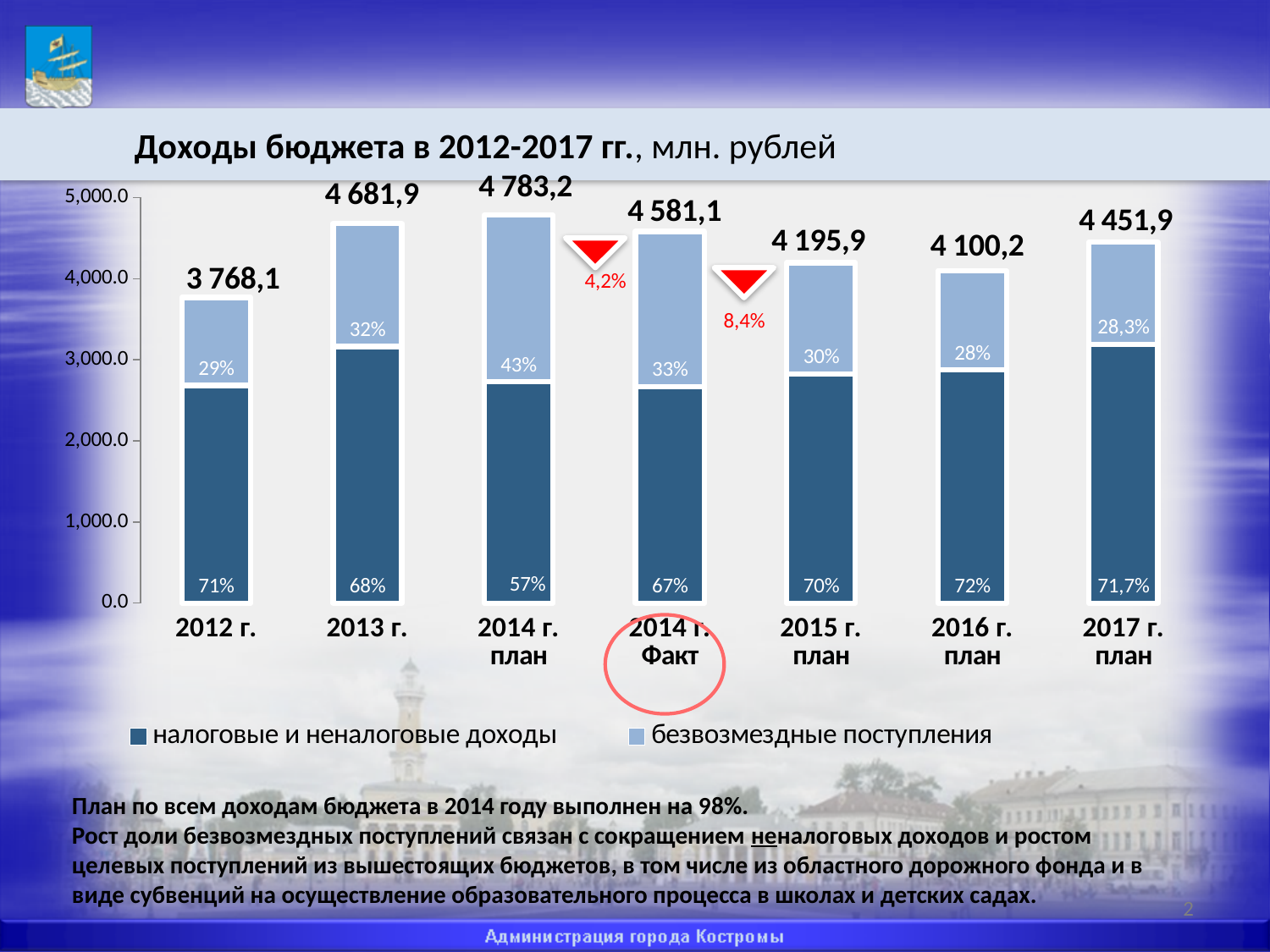
How many series does the legend list? 2 What is the total budget revenue shown for 2014 г. план? 4 783,2 Which is larger, the total for 2015 г. план or the total for 2016 г. план? 2015 г. план What percentage share do безвозмездные поступления make up in 2014 г. план? 43% What percentage share do налоговые и неналоговые доходы make up in 2017 г. план? 71,7% How many bars (categories) are shown on the chart? 7 Which year/category has the lowest total budget revenue? 2012 г. Which year/category has the highest total budget revenue? 2014 г. план Is the value of налоговые и неналоговые доходы for 2012 г. greater or less than 3,000.0? less What kind of chart is shown on the slide? Stacked bar chart What is the total budget revenue shown for 2017 г. план? 4 451,9 What is the difference between the total for 2014 г. план and the total for 2014 г. Факт? 202,1